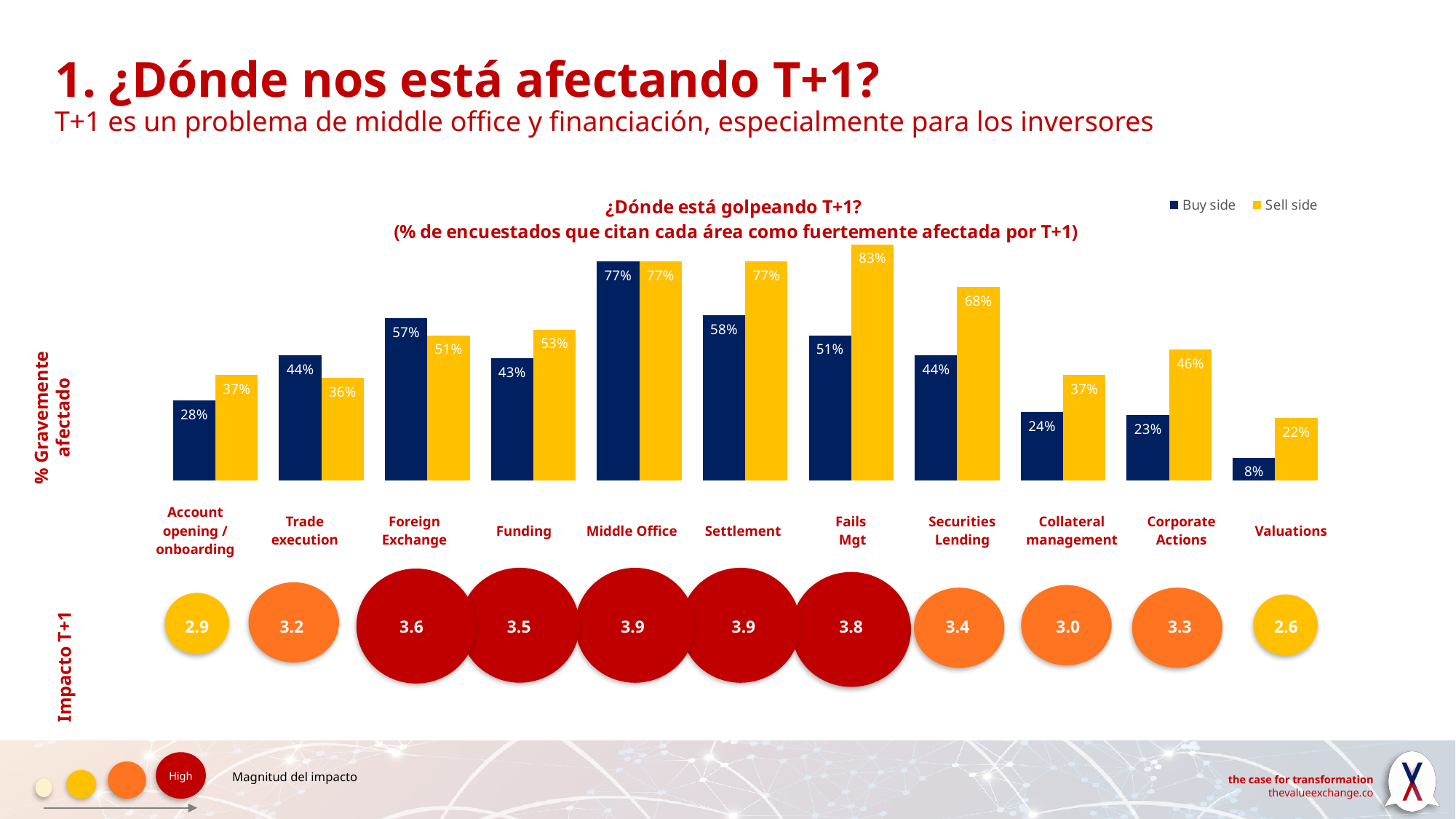
What kind of chart is used to show the percentage of respondents citing each area? Bar chart Which colour represents the Sell side series in the bar chart? Yellow What is the Impacto T+1 score shown for Settlement? 3.9 For Trade execution, which is larger: the Buy side value or the Sell side value? Buy side What is the Buy side value for Valuations? 8% What is the Sell side value for Fails Mgt? 83% What is the Buy side value for Middle Office? 77% Which category has the lowest Buy side value? Valuations What is the difference between the Sell side and Buy side values for Securities Lending? 24% How many series does the legend list? 2 How many categories are shown on the x axis of the bar chart? 11 Which category has the highest Sell side value? Fails Mgt